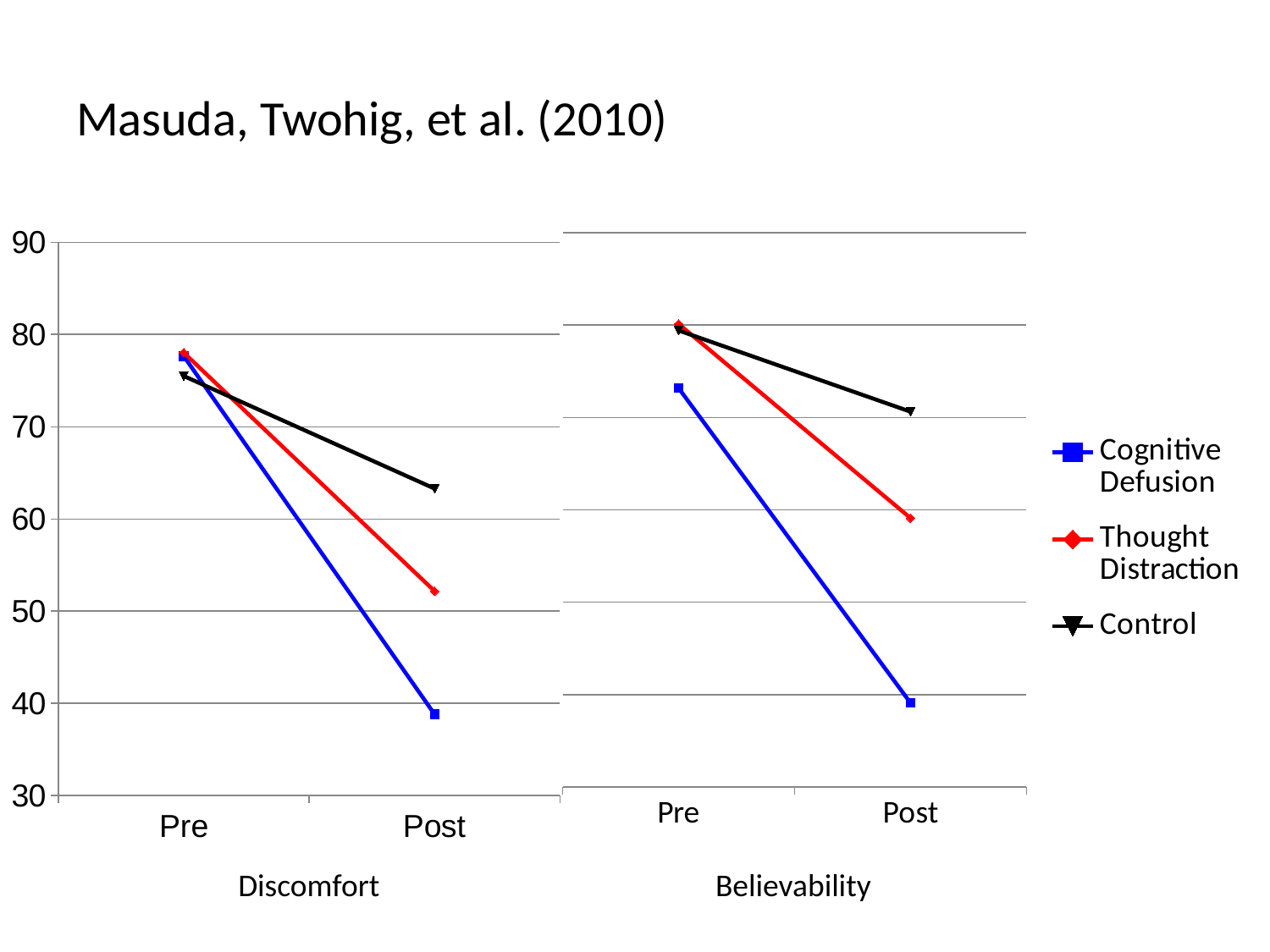
In the Believability chart, is the Cognitive Defusion value at Post greater or less than 50? less In the Discomfort chart, is the Control value at Post greater or less than 60? greater In the Believability chart, does the Control line rise or fall from Pre to Post? fall In the Discomfort chart, does the Cognitive Defusion line rise or fall from Pre to Post? fall What kind of chart is the Discomfort chart on the left? line chart Which series is drawn in red in the charts? Thought Distraction In the Believability chart, which series has the lowest value at Post? Cognitive Defusion How many x-axis categories does the Believability chart have? 2 In the Believability chart, which is larger at Pre: Thought Distraction or Cognitive Defusion? Thought Distraction In the Discomfort chart, which series has the highest value at Post? Control How many series does the legend list? 3 In the Discomfort chart, which is larger at Post: Control or Cognitive Defusion? Control